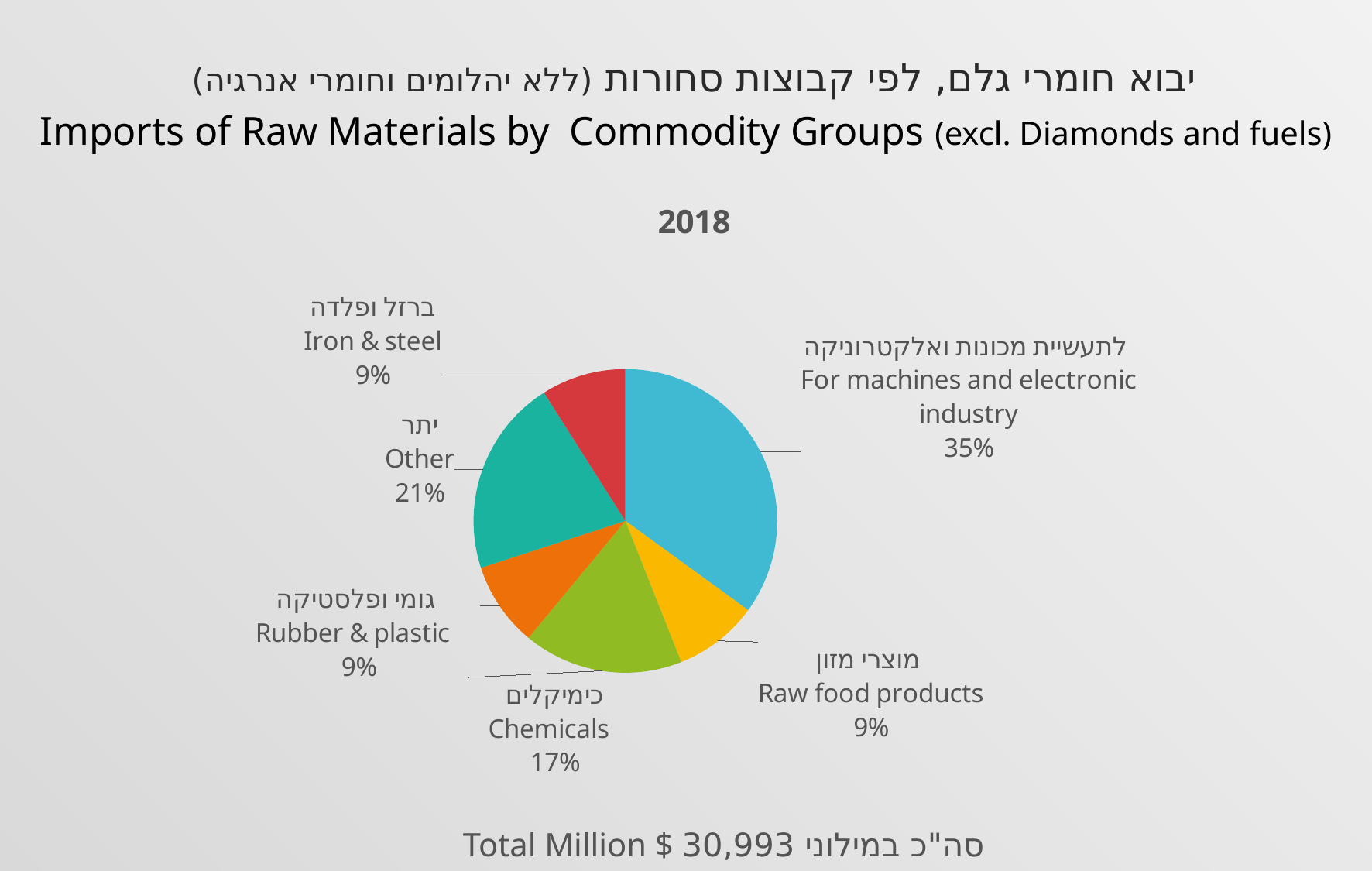
What is the difference in percentage points between 'For machines and electronic industry' and Chemicals? 18 What is the value shown for Chemicals? 17% What is the difference in percentage points between Other and Iron & steel? 12 What share of the pie does 'For machines and electronic industry' hold? 35% Which is larger, the share for Other or the share for Chemicals? Other Which category has the largest slice of the pie? For machines and electronic industry What year does the chart title indicate? 2018 What is the value shown for Other? 21% How many categories are shown in the pie chart? 6 What share is shown for Rubber & plastic? 9% What total in million $ is stated below the chart? 30,993 What kind of chart is shown on the slide? Pie chart